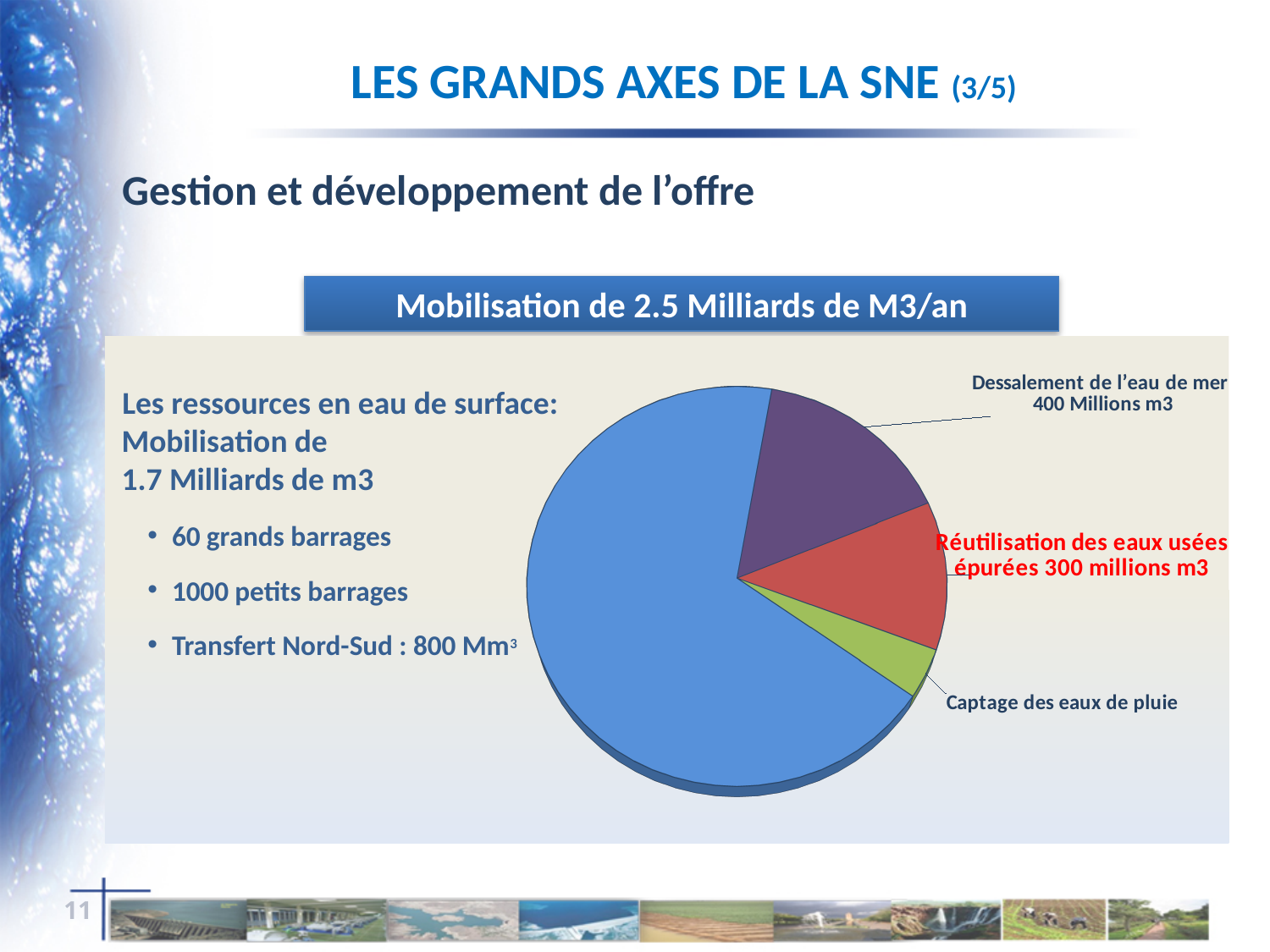
Which slice is larger, 'Captage des eaux de pluie' or 'Réutilisation des eaux usées épurées'? Réutilisation des eaux usées épurées What value is given for the 'Réutilisation des eaux usées épurées' slice? 300 millions m3 What kind of chart is shown on the slide? Pie chart How many slices does the pie chart have? 4 Which labeled slice of the pie chart is the smallest? Captage des eaux de pluie What is the heading shown in the blue banner above the pie chart? Mobilisation de 2.5 Milliards de M3/an What colour is the 'Dessalement de l'eau de mer' slice? Purple What value is given for the 'Dessalement de l'eau de mer' slice? 400 Millions m3 What is the difference between the 'Dessalement de l'eau de mer' value and the 'Réutilisation des eaux usées épurées' value? 100 millions m3 Which is larger, 'Dessalement de l'eau de mer' or 'Réutilisation des eaux usées épurées'? Dessalement de l'eau de mer